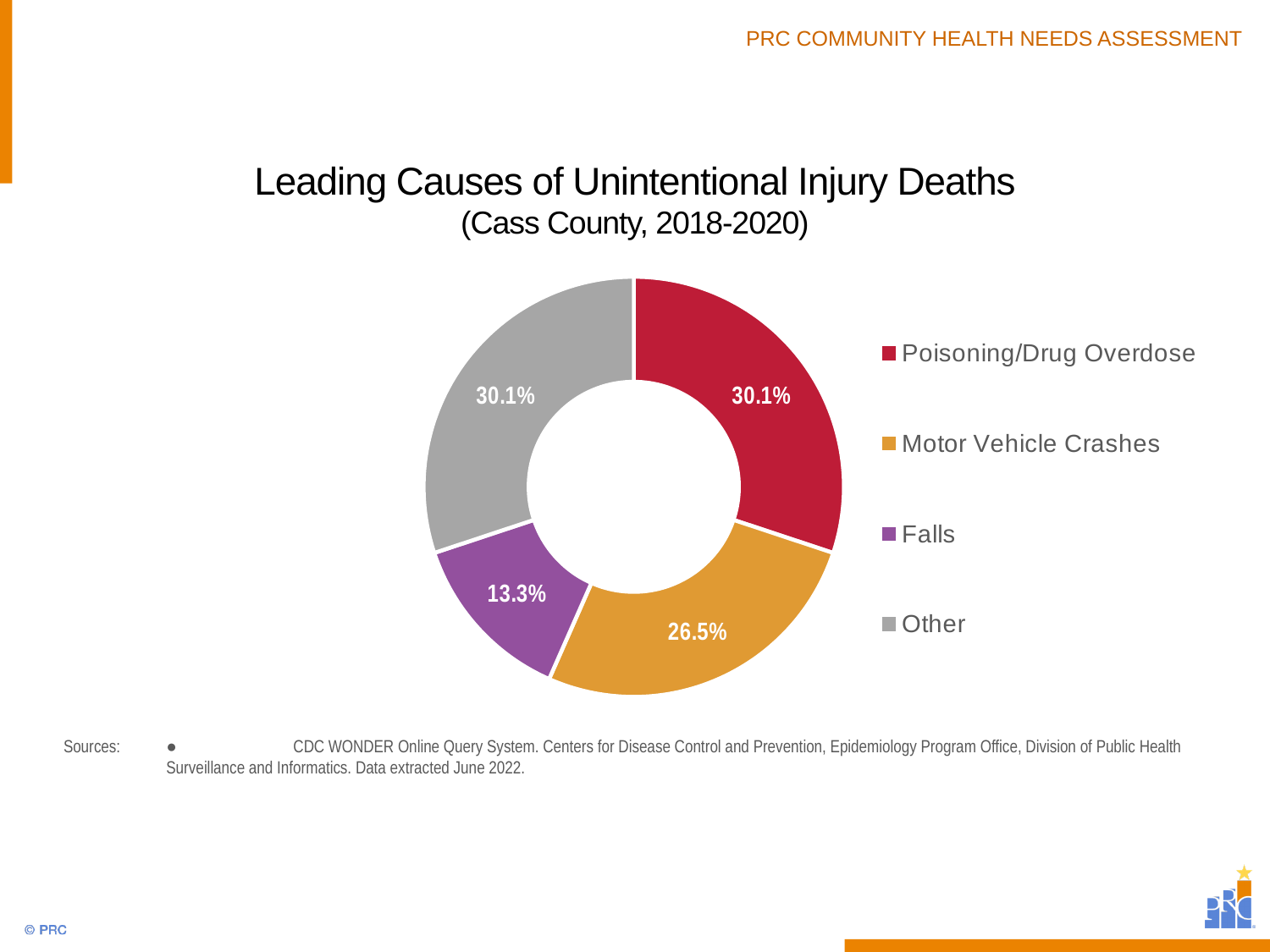
Which county and years does the chart title refer to? Cass County, 2018-2020 What is the difference in percentage points between Motor Vehicle Crashes and Falls? 13.2 What is the value shown for Poisoning/Drug Overdose? 30.1% What share is labelled for the Other category? 30.1% What kind of chart is shown on the slide? Pie chart (donut) Which cause has the smallest share of unintentional injury deaths? Falls How many categories are shown in the chart? 4 What percentage of the chart does Falls represent? 13.3% What is the difference in percentage points between Poisoning/Drug Overdose and Motor Vehicle Crashes? 3.6 Which is larger, the share for Other or the share for Motor Vehicle Crashes? Other What share of unintentional injury deaths is attributed to Motor Vehicle Crashes? 26.5% Which is larger, the share for Motor Vehicle Crashes or the share for Falls? Motor Vehicle Crashes